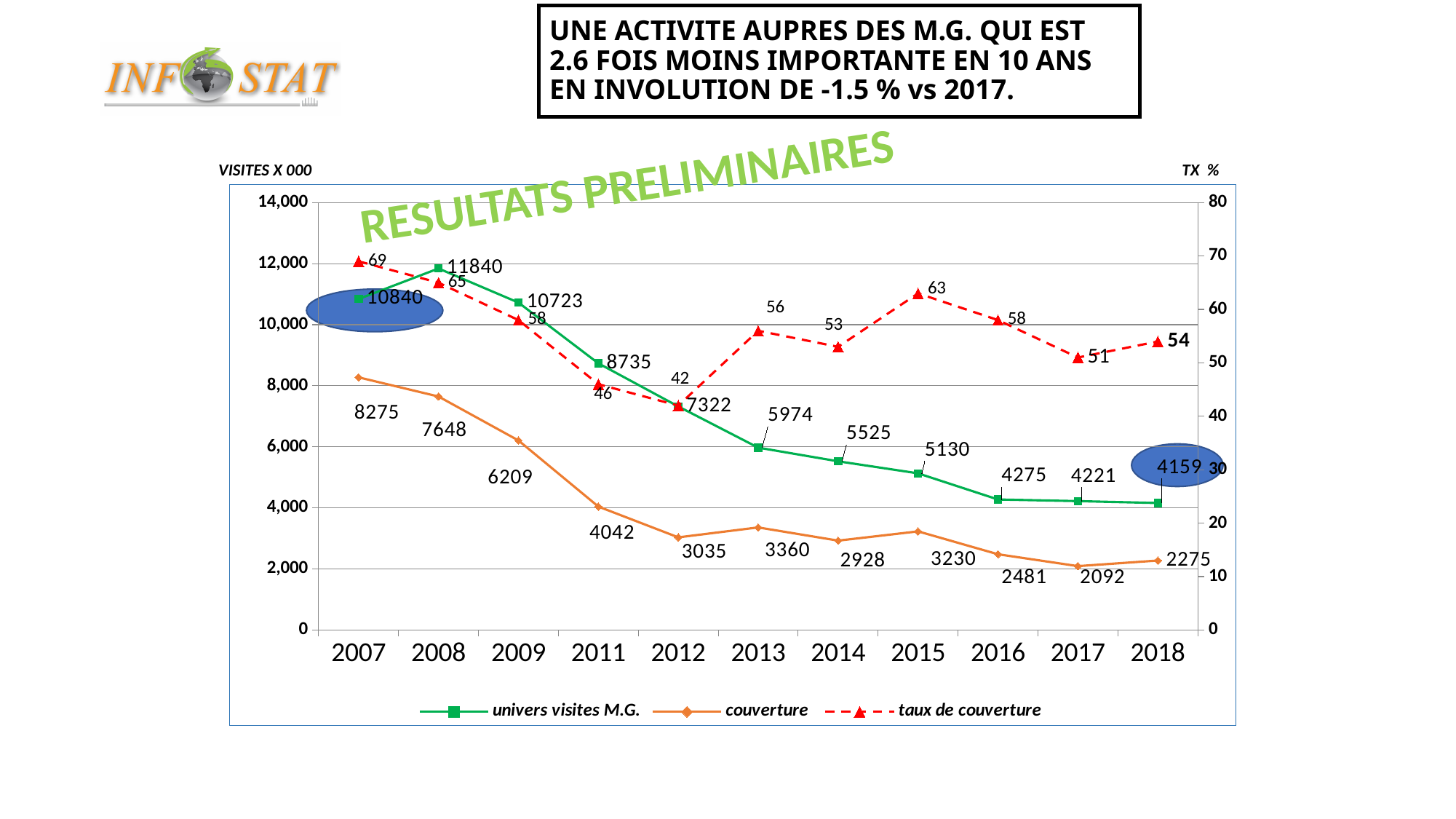
How many series does the legend list? 3 What is the difference between univers visites M.G. in 2017 and in 2018? 62 Which is larger, couverture in 2013 or couverture in 2014? couverture in 2013 What is the value of couverture in 2017? 2092 What is the taux de couverture in 2015? 63 In which year is the taux de couverture lowest? 2012 Which series is drawn with a red dashed line? taux de couverture What type of chart is shown on the slide? line chart How many years are shown on the x axis? 11 What is the value of univers visites M.G. in 2008? 11840 In which year is univers visites M.G. highest? 2008 Does univers visites M.G. generally rise or fall from 2008 to 2018? fall